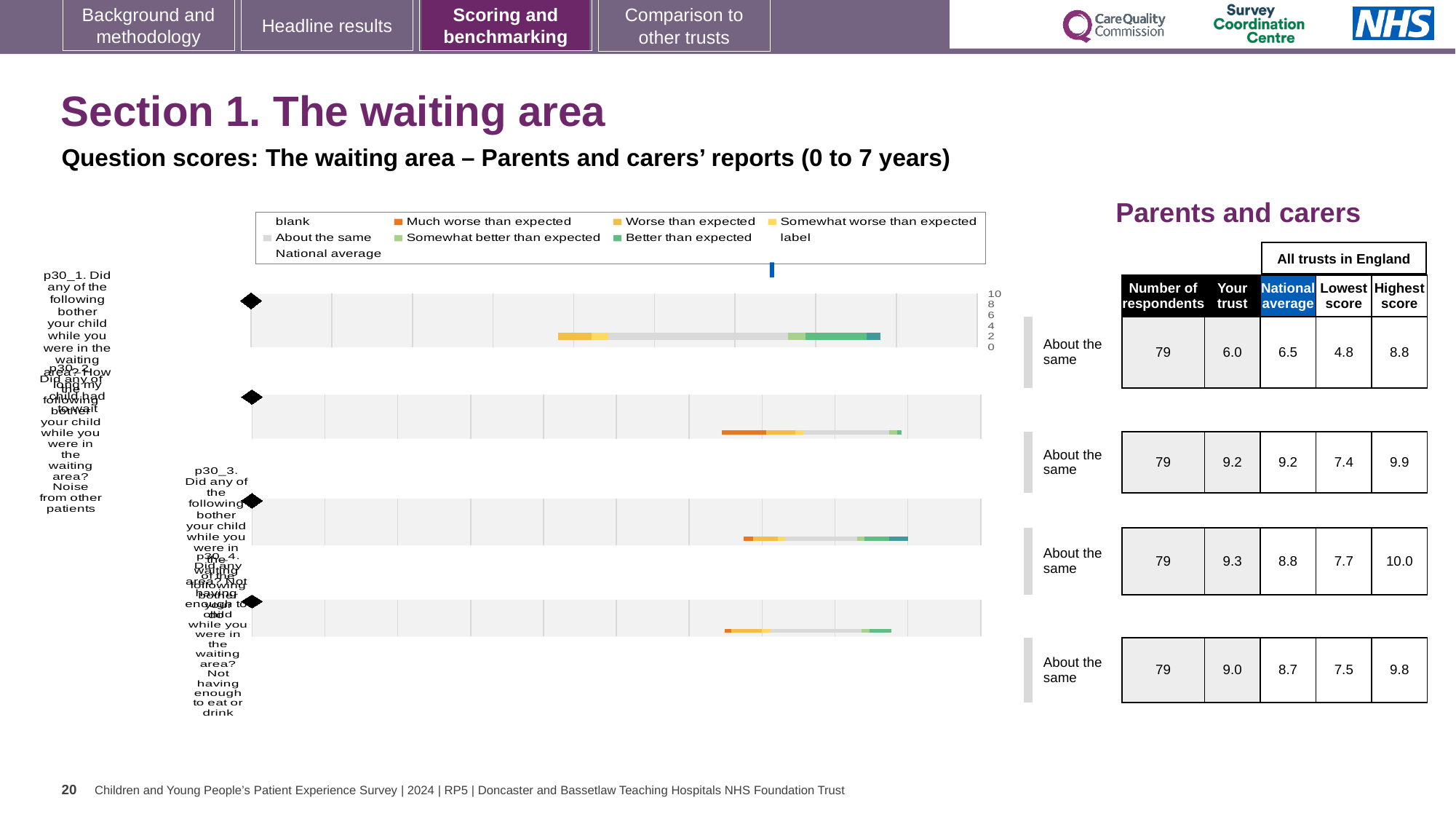
In the table next to the chart, is the 'Your trust' score for p30_2 larger or smaller than the national average for p30_2? the same (9.2) How many respondents are listed for each question in the table next to the chart? 79 Which colour does the legend use for 'Much worse than expected'? orange How many question bars (p30_1 to p30_4) are plotted in the chart? 4 What kind of chart is shown on the slide? bar chart In the table next to the chart, what is the 'Your trust' score for the first question (p30_1, long wait)? 6.0 In the table next to the chart, which question has the highest 'Your trust' score? p30_3 (not having enough to do) In the table next to the chart, which question has the lowest 'Your trust' score? p30_1 (long wait) What benchmark category is shown beside every bar in the chart? About the same In the table next to the chart, what is the difference between the highest score (10.0) and the lowest score (7.7) for p30_3? 2.3 What is the highest value shown on the chart's axis? 10